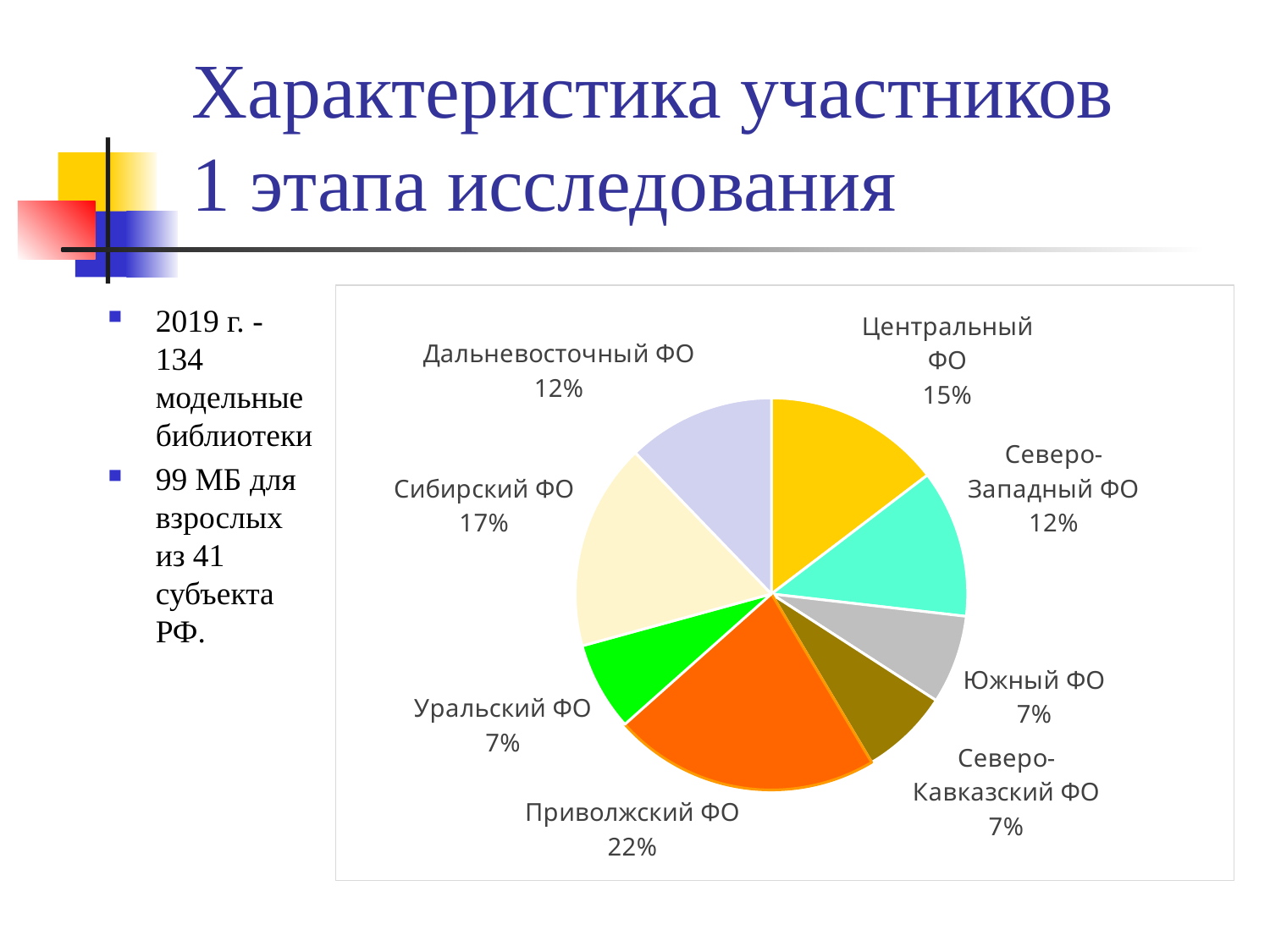
Which is larger, the share of Центральный ФО or the share of Северо-Западный ФО? Центральный ФО What share of the pie does Уральский ФО have? 7% What colour is the slice for Приволжский ФО? orange What share of the pie does Дальневосточный ФО have? 12% What share of the pie does Сибирский ФО have? 17% How many slices does the pie chart have? 8 What kind of chart is shown on the slide? pie chart What is the difference in percentage points between Центральный ФО and Южный ФО? 8 What is the difference in percentage points between Приволжский ФО and Сибирский ФО? 5 Which federal district has the largest slice of the pie? Приволжский ФО